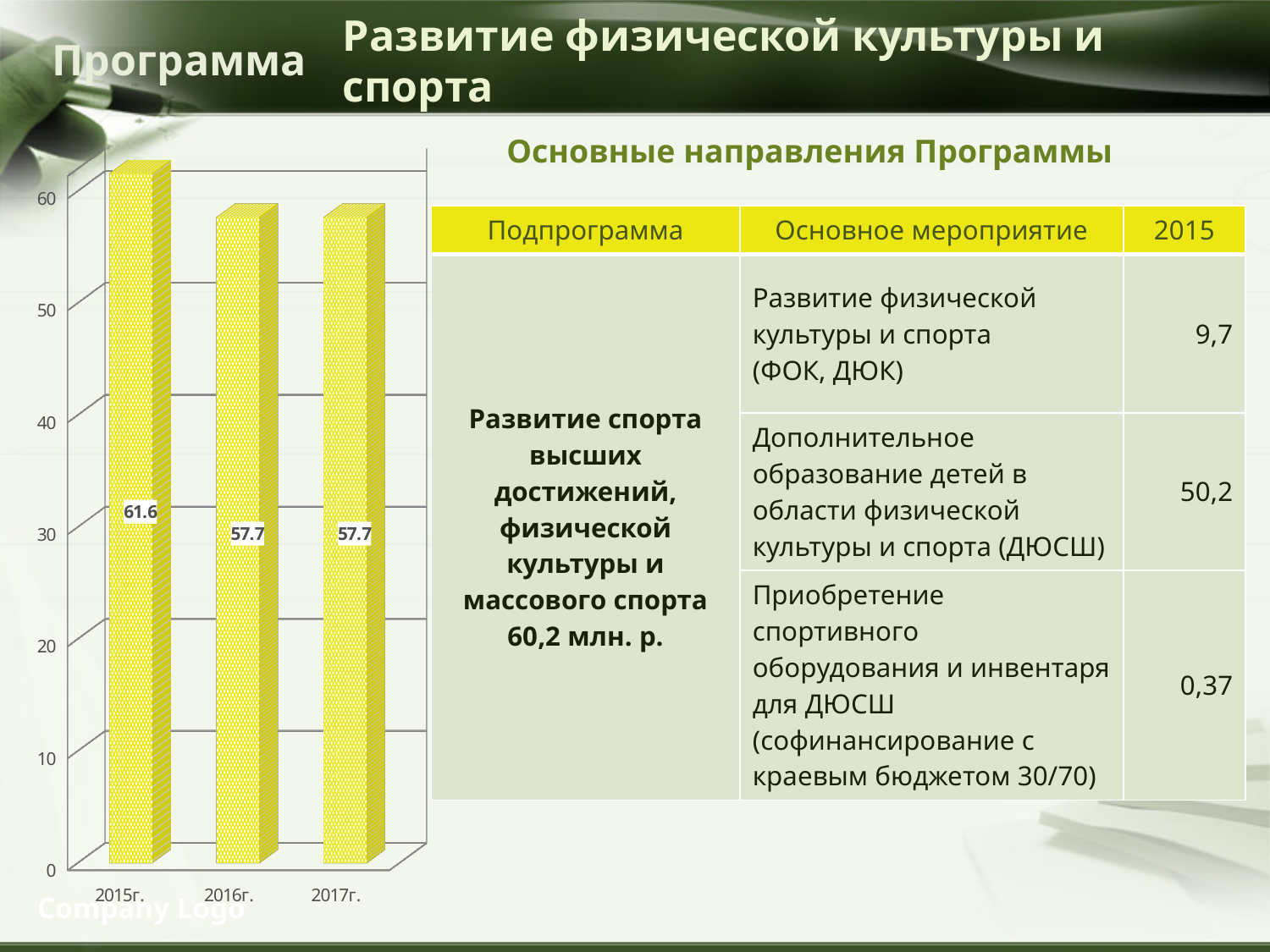
How many categories are shown on the x axis of the chart? 3 Is the value for 2015г. greater or less than 60? greater Is the value for 2016г. greater or less than 60? less Which is larger, the value for 2015г. or the value for 2017г.? 2015г. What is the difference between the values for 2015г. and 2016г.? 3.9 What colour are the bars in the chart? yellow What kind of chart is shown on the slide? bar chart Do the values rise or fall from 2015г. to 2016г.? fall Which year has the highest value? 2015г. What is the value for 2015г.? 61.6 What is the value for 2016г.? 57.7 What is the value for 2017г.? 57.7